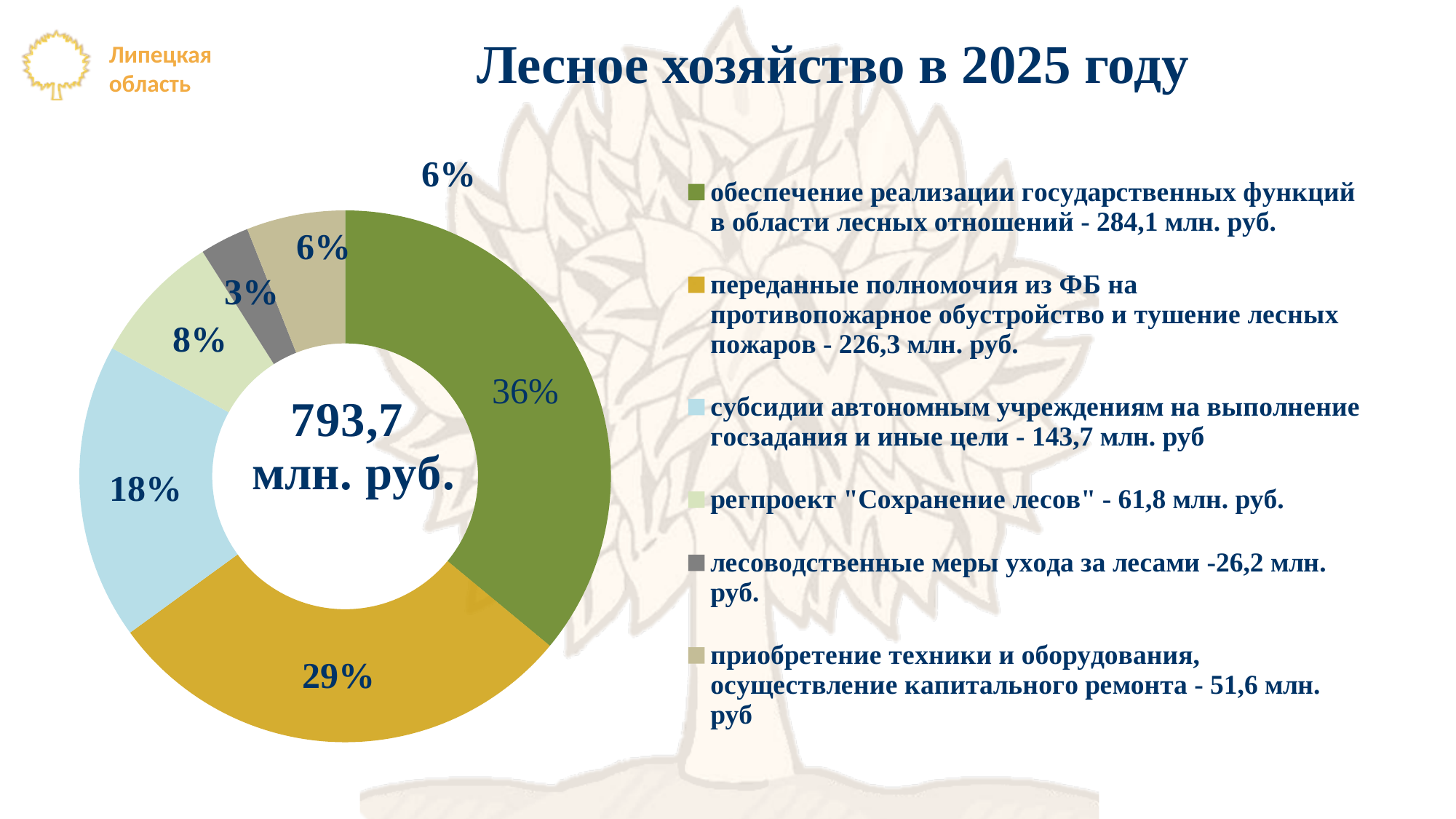
What share of the chart does the slice for "субсидии автономным учреждениям на выполнение госзадания и иные цели" represent? 18% What share of the chart does the slice for "переданные полномочия из ФБ на противопожарное обустройство и тушение лесных пожаров" represent? 29% What total amount is shown in the centre of the chart? 793,7 млн. руб. What kind of chart is shown on the slide? doughnut (pie) chart What share of the chart does the slice for "лесоводственные меры ухода за лесами" represent? 3% Which category has the largest share of the chart? обеспечение реализации государственных функций в области лесных отношений How many categories does the legend list? 6 What is the difference in млн. руб. between "обеспечение реализации государственных функций в области лесных отношений" (284,1) and "переданные полномочия из ФБ" (226,3)? 57,8 млн. руб. What is the value for "регпроект "Сохранение лесов"" according to the legend? 61,8 млн. руб. What is the value for "приобретение техники и оборудования, осуществление капитального ремонта" according to the legend? 51,6 млн. руб Which category has the smallest share of the chart? лесоводственные меры ухода за лесами